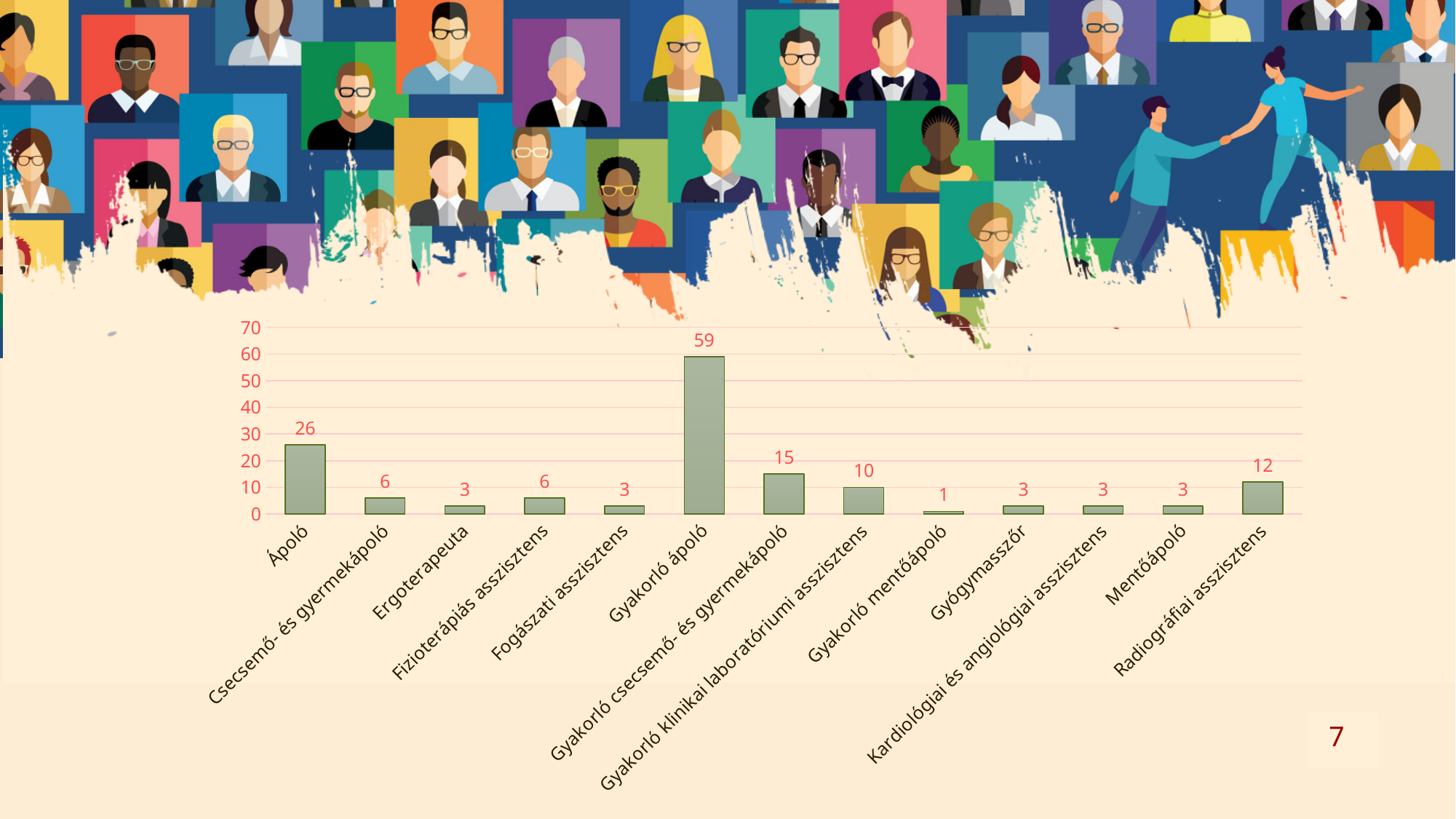
What is the difference between the values for Gyakorló ápoló and Ápoló? 33 What kind of chart is shown on the slide? bar chart What is the value for Ápoló? 26 What is the value for Radiográfiai asszisztens? 12 What is the highest value shown on the y axis? 70 Which category has the highest value? Gyakorló ápoló How many categories are shown on the x axis? 13 What is the value for Gyakorló csecsemő- és gyermekápoló? 15 What is the value for Ergoterapeuta? 3 What is the value for Gyakorló ápoló? 59 Which category has the lowest value? Gyakorló mentőápoló Which is larger, the value for Gyakorló klinikai laboratóriumi asszisztens or the value for Radiográfiai asszisztens? Radiográfiai asszisztens